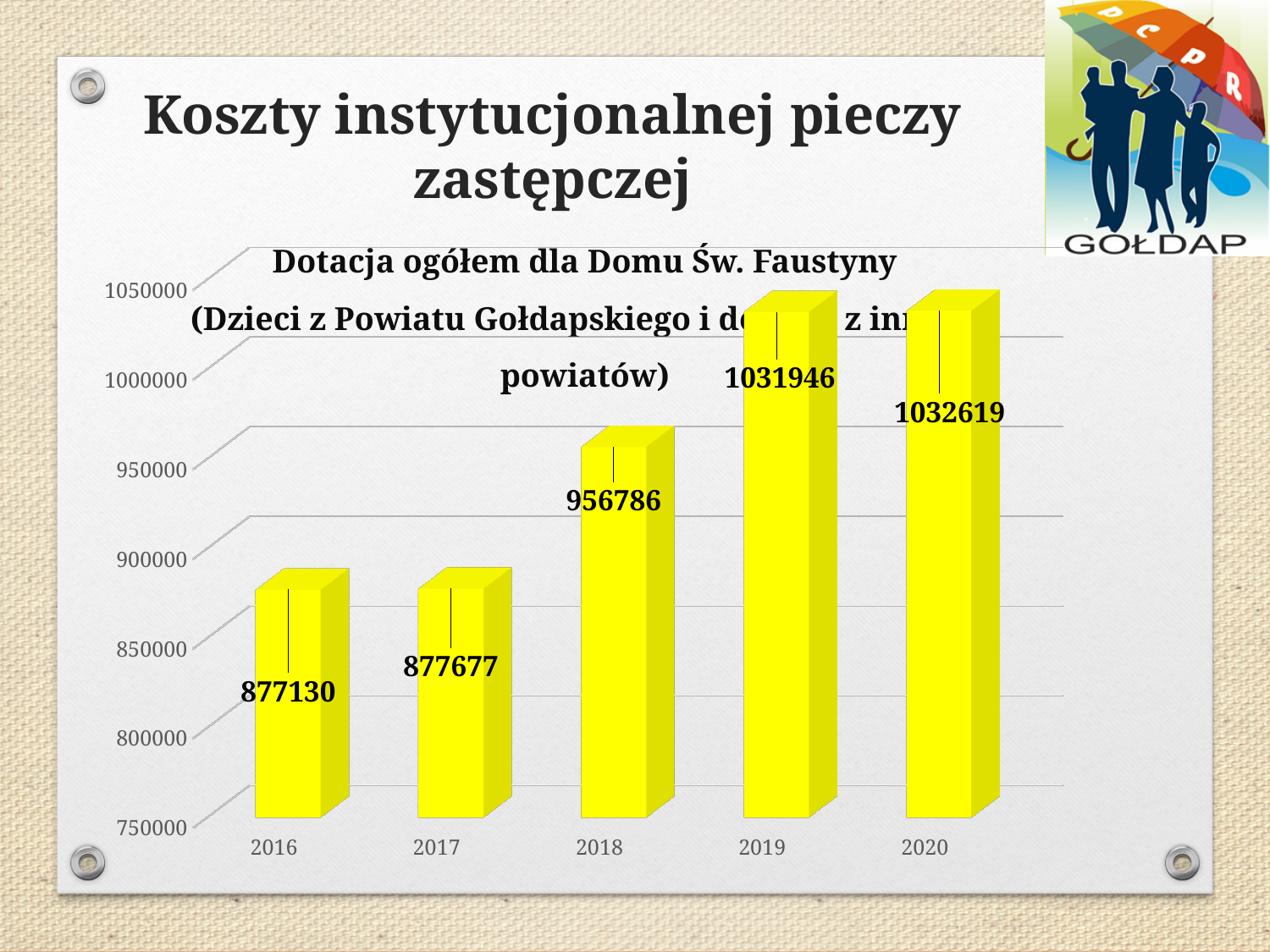
What is the value for 2020? 1032619 Do the values rise or fall from 2016 to 2020? rise What is the difference between the values for 2018 and 2017? 79109 Which is larger, the value for 2018 or the value for 2019? 2019 Which year has the highest value? 2020 What is the difference between the values for 2020 and 2016? 155489 What is the value for 2016? 877130 What kind of chart is shown on the slide? bar chart What is the value for 2018? 956786 Which year has the lowest value? 2016 Is the value for 2016 greater or less than 900000? less How many years are shown on the x axis? 5